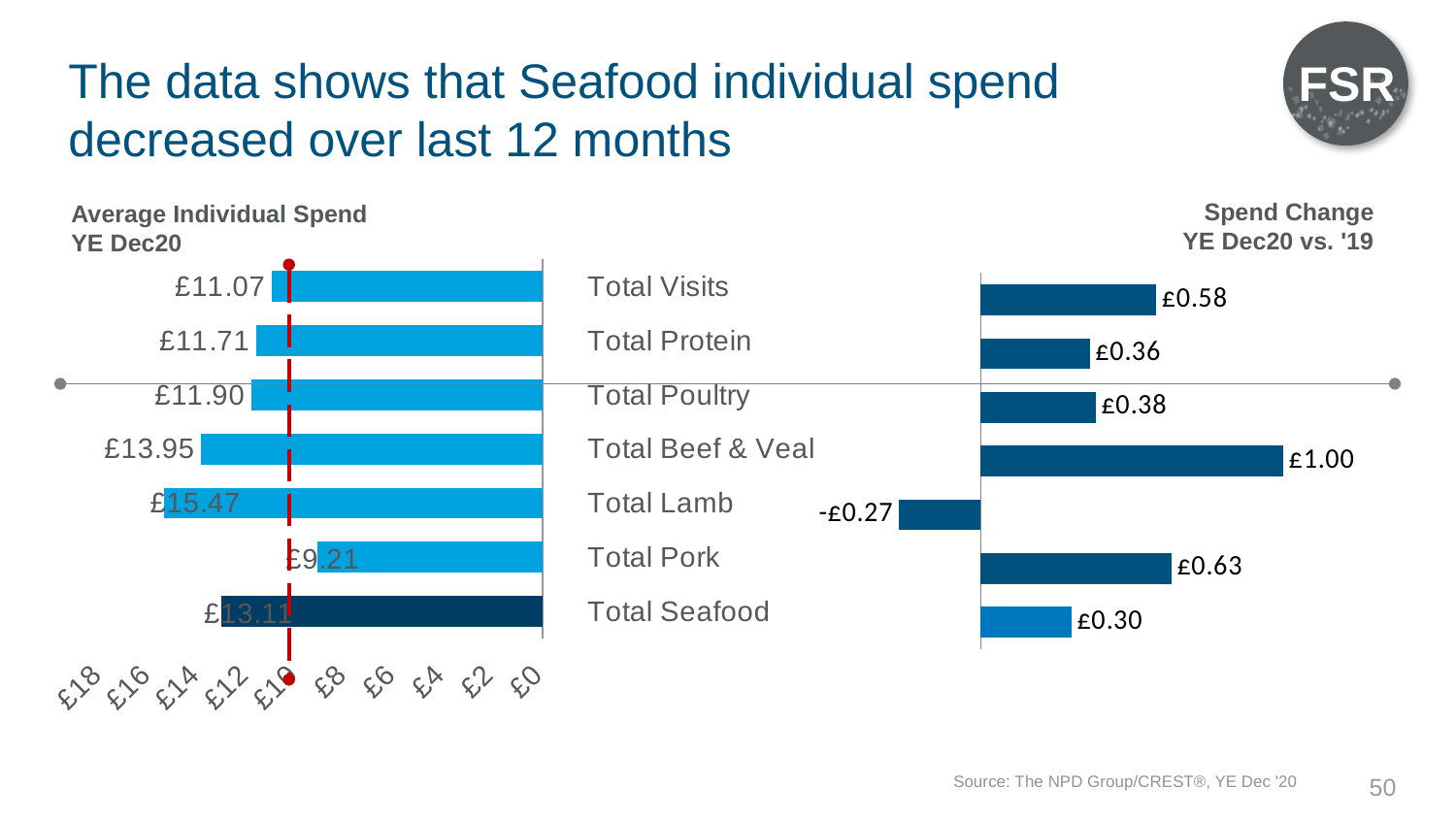
In the Average Individual Spend YE Dec20 chart, how many categories are shown? 7 In the Spend Change YE Dec20 vs. '19 chart, which is larger, Total Pork or Total Seafood? Total Pork In the Average Individual Spend YE Dec20 chart, which category has the highest value? Total Lamb In the Spend Change YE Dec20 vs. '19 chart, which category has the lowest value? Total Lamb In the Average Individual Spend YE Dec20 chart, what is the difference between Total Lamb and Total Pork? £6.26 In the Average Individual Spend YE Dec20 chart, which category has the lowest value? Total Pork In the Average Individual Spend YE Dec20 chart, what is the value for Total Pork? £9.21 In the Spend Change YE Dec20 vs. '19 chart, what is the value for Total Beef & Veal? £1.00 In the Spend Change YE Dec20 vs. '19 chart, what is the value for Total Lamb? -£0.27 In the Average Individual Spend YE Dec20 chart, what is the value for Total Seafood? £13.11 In the Spend Change YE Dec20 vs. '19 chart, what is the difference between Total Visits and Total Protein? £0.22 What type of chart is the Average Individual Spend YE Dec20 chart? Bar chart